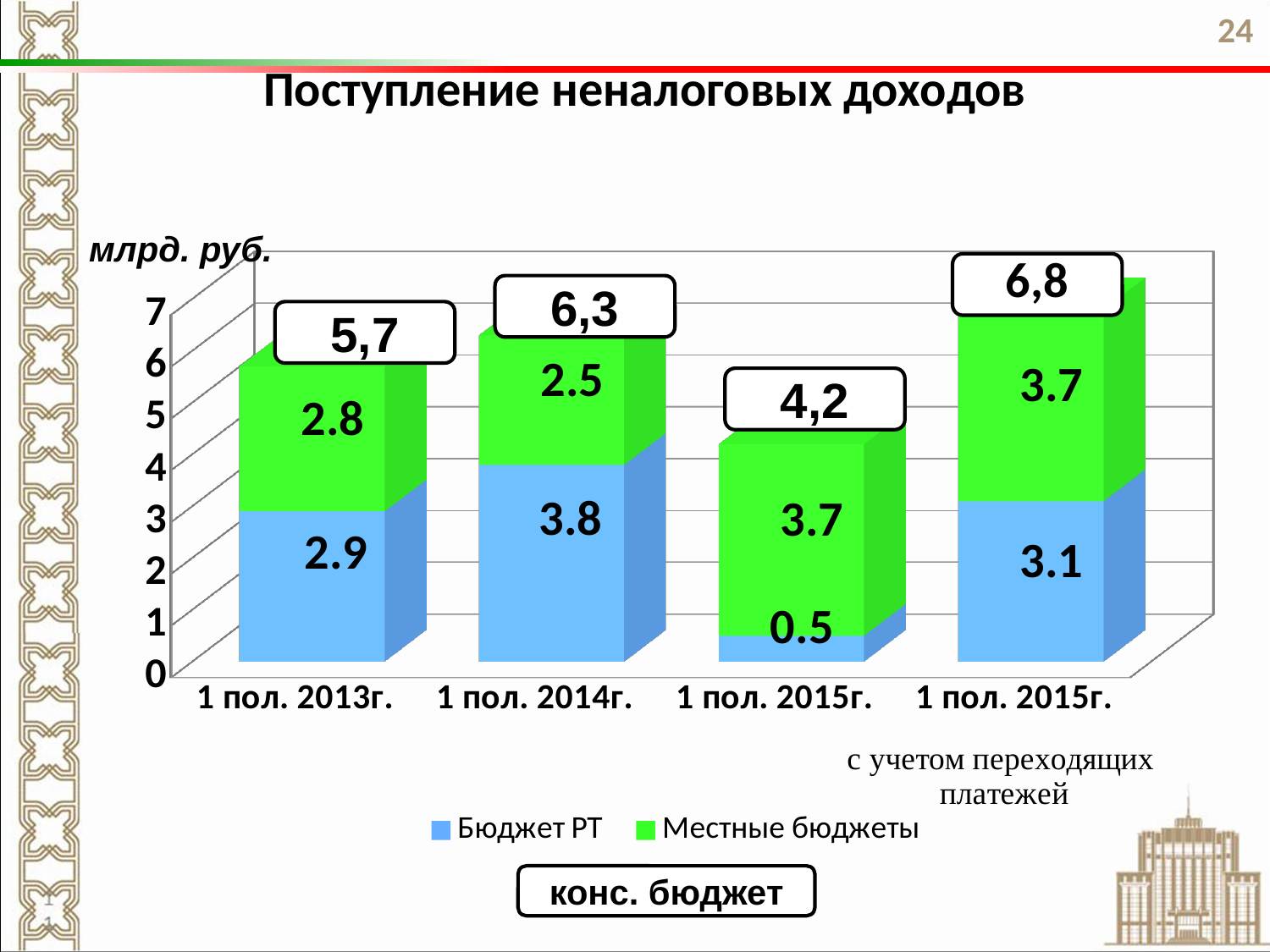
How many series does the legend list? 2 What is the value for Местные бюджеты in the rightmost bar (1 пол. 2015г. с учетом переходящих платежей)? 3.7 Which bar has the highest total (конс. бюджет)? 1 пол. 2015г. (с учетом переходящих платежей) What is the difference between the Бюджет РТ values for 1 пол. 2014г. and 1 пол. 2013г.? 0.9 Which bar has the lowest total (конс. бюджет)? 1 пол. 2015г. (third bar) What is the value for Местные бюджеты in 1 пол. 2014г.? 2.5 What is the value for Бюджет РТ in the third bar (1 пол. 2015г.)? 0.5 How many bars (categories) are shown on the chart? 4 What is the total of the stacked bar for 1 пол. 2014г.? 6,3 What type of chart is shown on the slide? Stacked bar chart Which is larger: Бюджет РТ in 1 пол. 2014г. or Бюджет РТ in the rightmost bar (1 пол. 2015г. с учетом переходящих платежей)? 1 пол. 2014г. What is the value for Бюджет РТ in 1 пол. 2013г.? 2.9